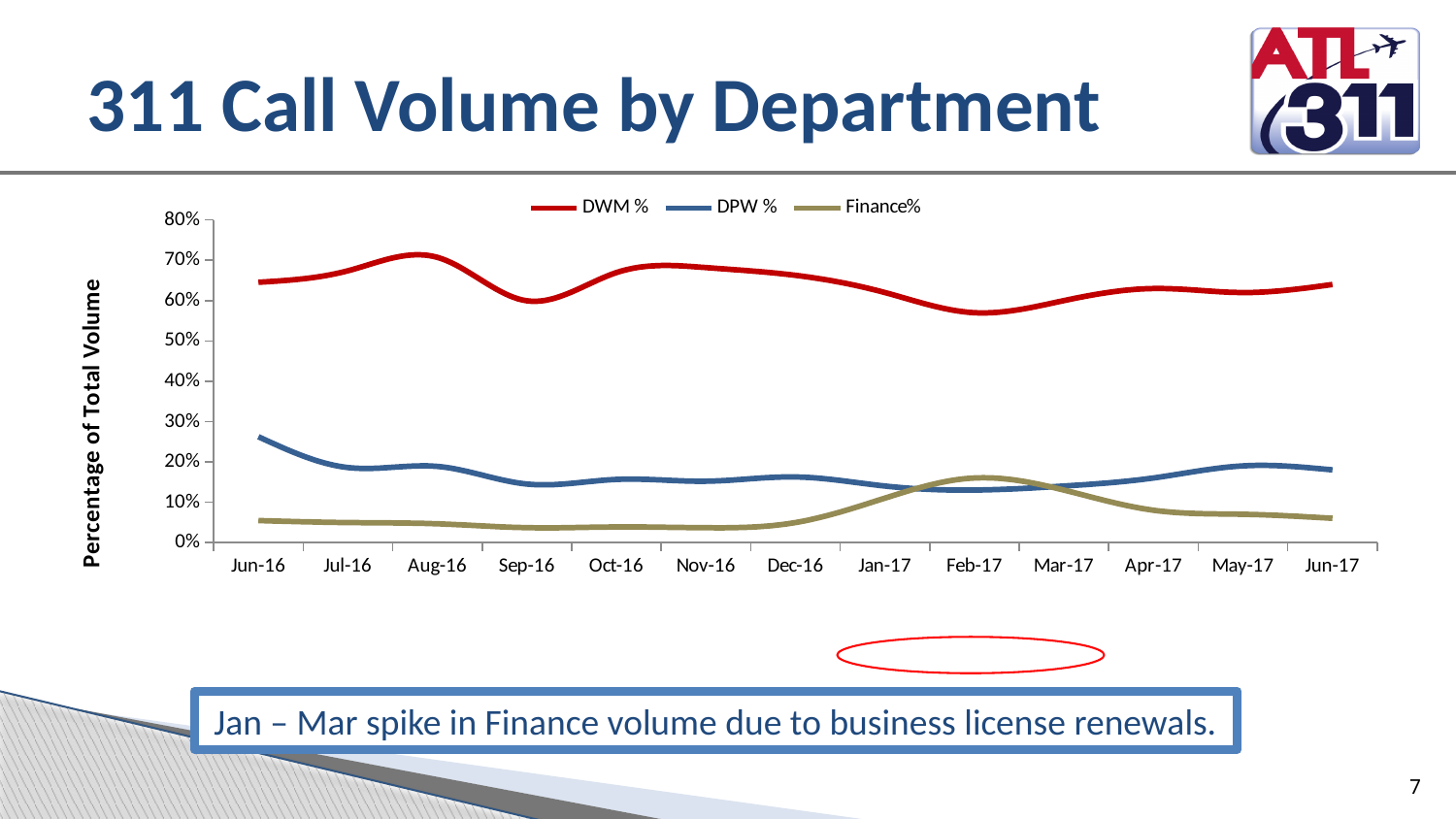
What kind of chart is shown on the slide? Line chart In which month does DPW % reach its highest value? Jun-16 Is the value for DWM % in Feb-17 greater or less than 60%? less What is the label on the y axis of the chart? Percentage of Total Volume How many series does the legend list? 3 Is the value for DPW % in Jun-16 greater or less than 20%? greater How many months are plotted along the x axis? 13 Does Finance% rise or fall from Dec-16 to Feb-17? rise Is the value for Finance% in Jun-16 greater or less than 10%? less Which is larger in Jun-16, DPW % or Finance%? DPW % In which month does DWM % reach its lowest value? Feb-17 Which series has the highest values throughout the chart? DWM %